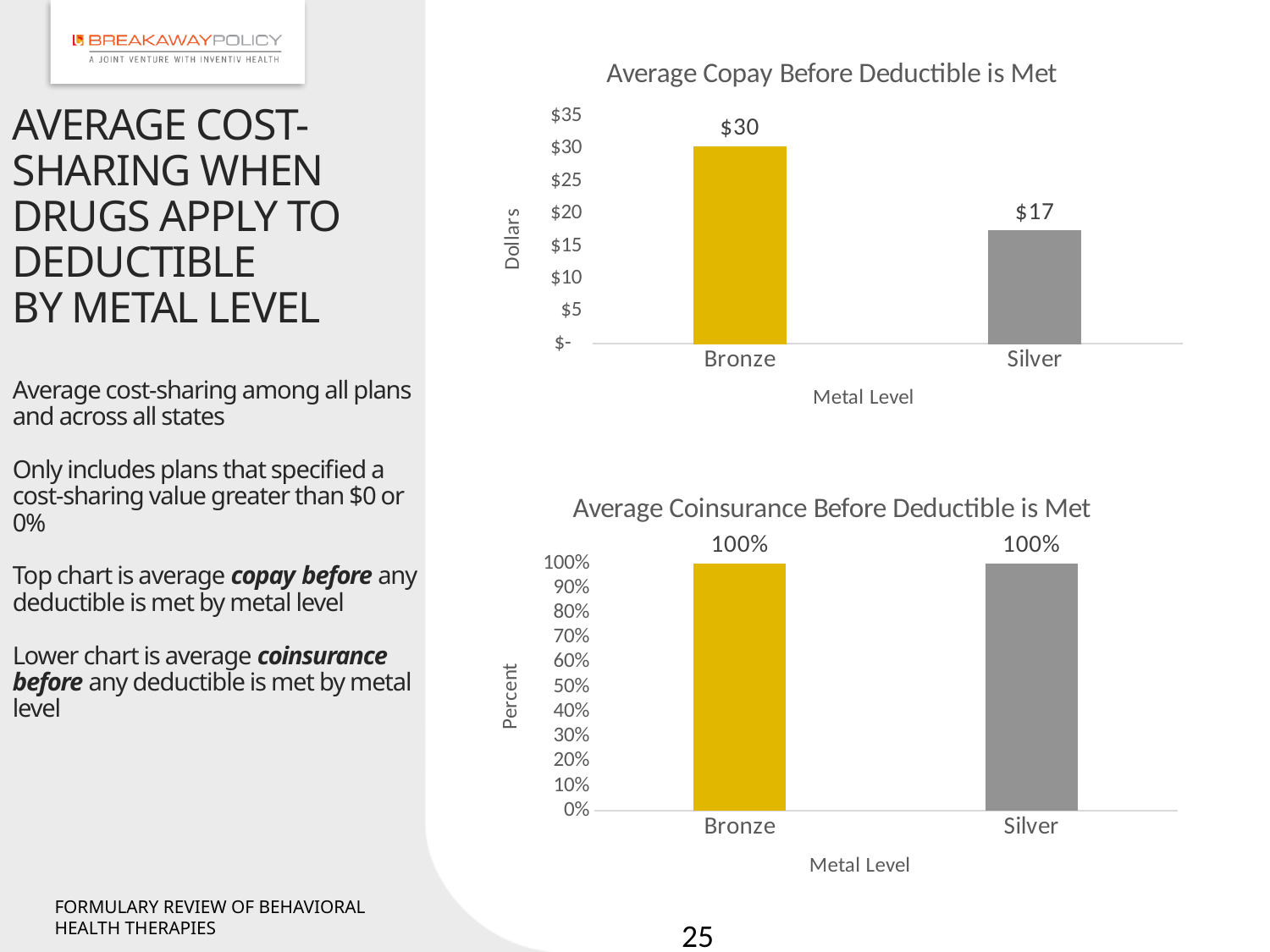
In the 'Average Coinsurance Before Deductible is Met' chart, what is the value for Silver? 100% What is the y-axis label of the 'Average Copay Before Deductible is Met' chart? Dollars In the 'Average Copay Before Deductible is Met' chart, what is the value for Bronze? $30 In the 'Average Copay Before Deductible is Met' chart, what is the value for Silver? $17 In the 'Average Coinsurance Before Deductible is Met' chart, what is the value for Bronze? 100% How many metal levels are shown in the 'Average Coinsurance Before Deductible is Met' chart? 2 What kind of chart is the 'Average Copay Before Deductible is Met' chart? Bar chart In the 'Average Copay Before Deductible is Met' chart, what is the difference between the Bronze and Silver values? $13 In the 'Average Copay Before Deductible is Met' chart, is the value for Silver greater or less than $20? less In the 'Average Copay Before Deductible is Met' chart, which metal level has the highest average copay? Bronze What is the x-axis label of the 'Average Coinsurance Before Deductible is Met' chart? Metal Level In the 'Average Copay Before Deductible is Met' chart, which metal level has the lowest average copay? Silver